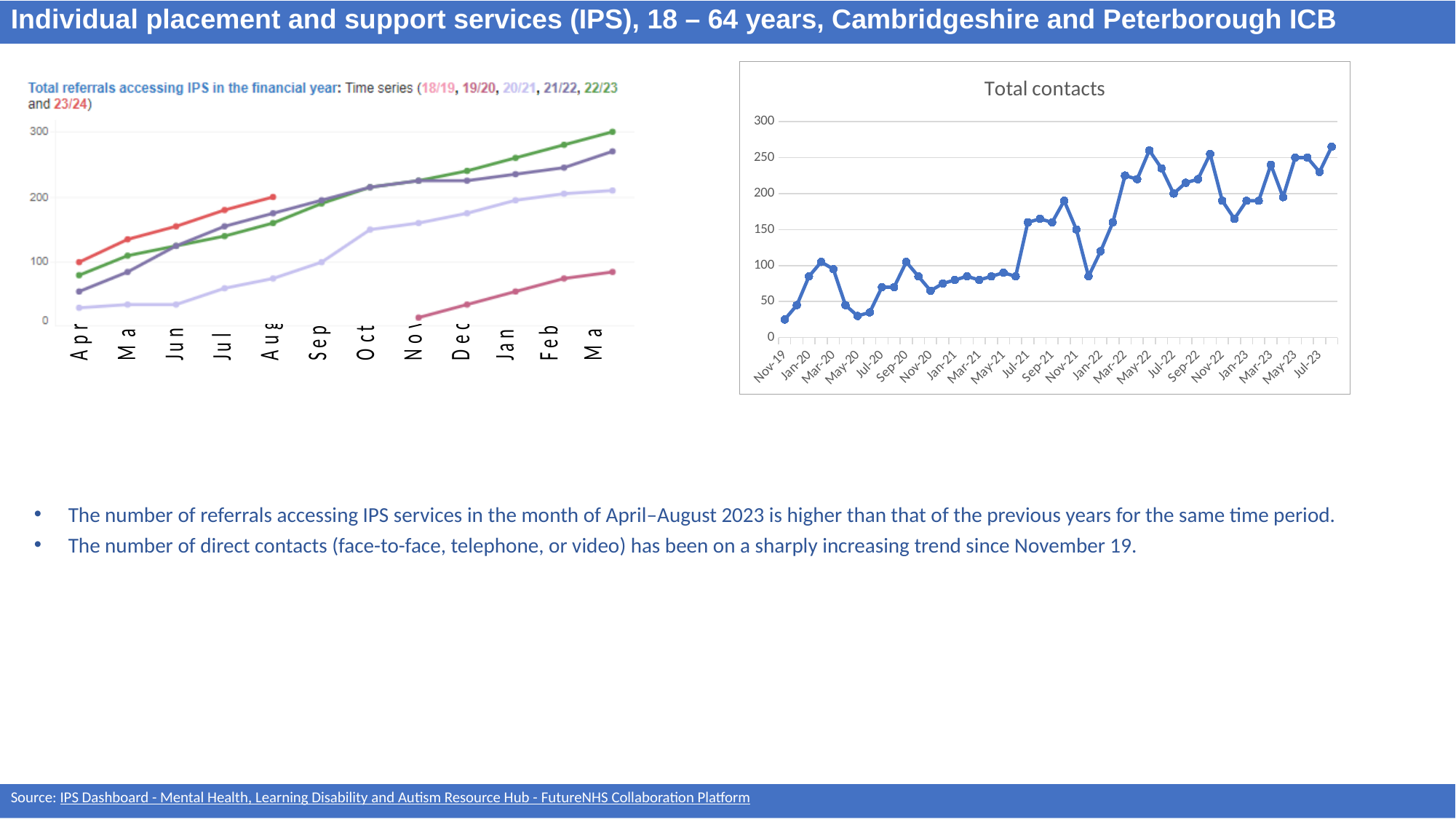
In the 'Total referrals accessing IPS in the financial year' chart, is the 23/24 value for Aug greater or less than 150? greater In the 'Total referrals accessing IPS in the financial year' chart, is the 22/23 value for Mar greater or less than 250? greater What kind of chart is the 'Total referrals accessing IPS in the financial year' chart on the left of the slide? line chart How many months are shown on the x axis of the 'Total referrals accessing IPS in the financial year' chart? 12 In the 'Total contacts' chart, do the values generally rise or fall from Nov-19 to Jul-23? rise In the 'Total referrals accessing IPS in the financial year' chart, which financial-year series has the highest value in Mar? 22/23 In the 'Total contacts' chart, is the value for Jul-23 greater or less than 200? greater How many financial-year series does the 'Total referrals accessing IPS in the financial year' chart show? 6 In the 'Total referrals accessing IPS in the financial year' chart, which financial-year series has the lowest value in Apr? 20/21 What kind of chart is the 'Total contacts' chart on the right of the slide? line chart